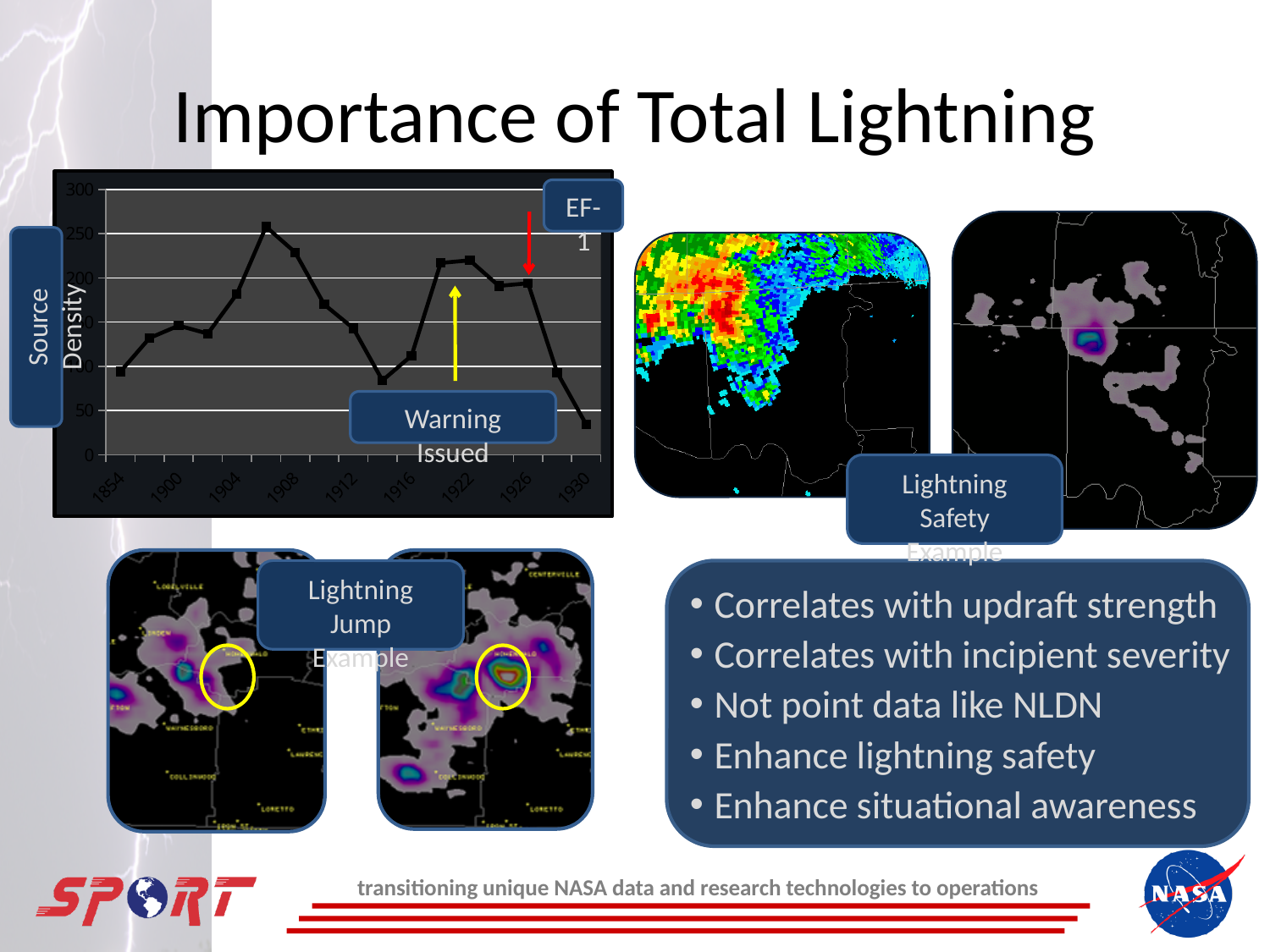
On the line chart, which is larger, the value at 1922 or the value at 1916? 1922 What kind of chart is shown on the left of the slide? line chart On the line chart, which is larger, the value at 1904 or the value at 1912? 1904 Which labelled x-axis category has the lowest value on the line chart? 1930 On the line chart, does the line rise or fall between 1926 and 1930? fall Is the value at 1912 on the line chart greater or less than 100? greater Is the value at 1916 on the line chart greater or less than 150? less Is the value at 1930 on the line chart greater or less than 50? less What is the highest value shown on the y axis of the line chart? 300 What is the title of the y axis on the line chart? Source Density